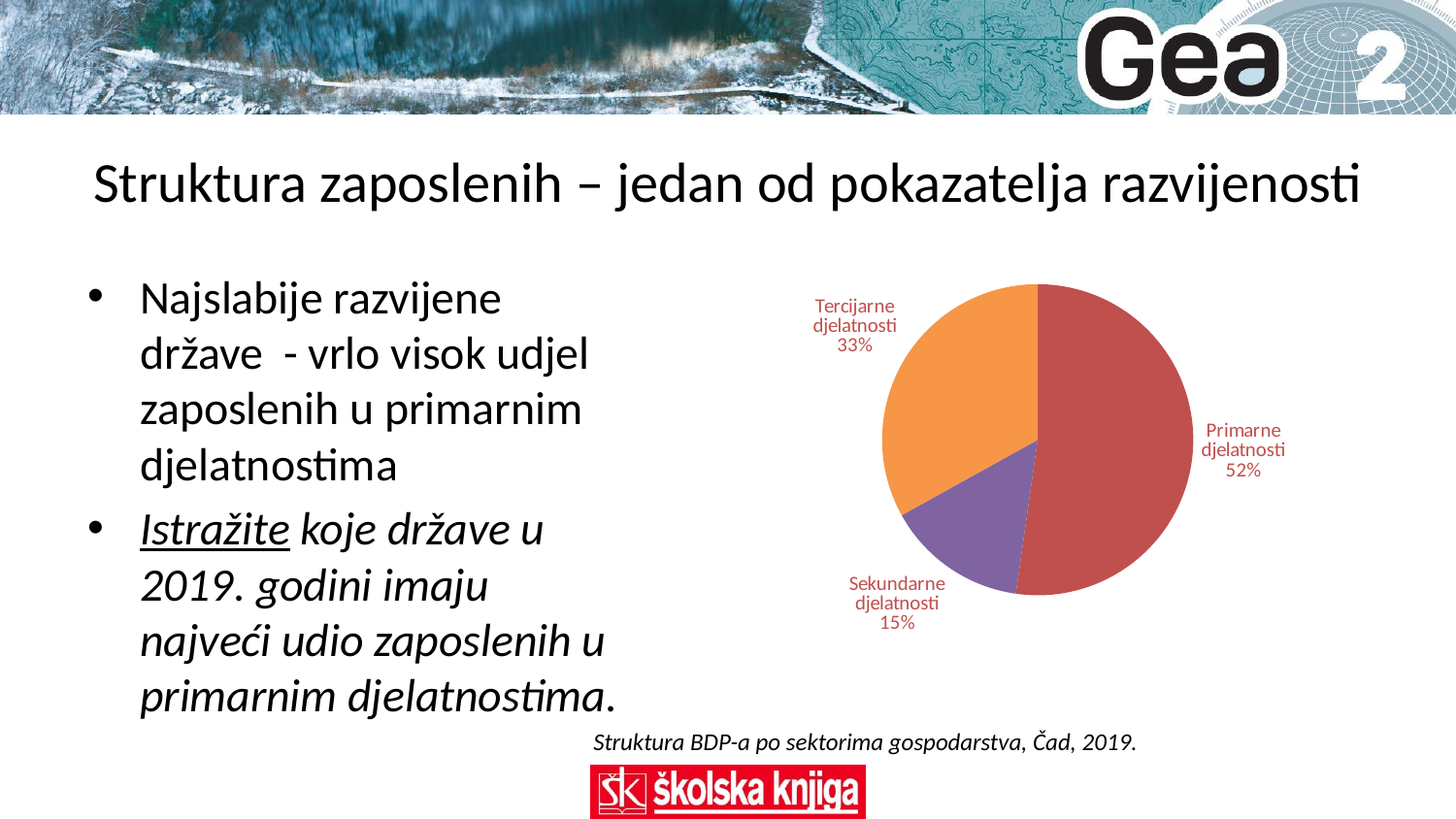
What is the difference in percentage points between Tercijarne djelatnosti and Sekundarne djelatnosti? 18 What is the caption below the pie chart? Struktura BDP-a po sektorima gospodarstva, Čad, 2019. What colour is the Sekundarne djelatnosti slice? purple How many slices does the pie chart have? 3 What is the difference in percentage points between Primarne djelatnosti and Tercijarne djelatnosti? 19 What share of the pie chart is Sekundarne djelatnosti? 15% What share of the pie chart is Tercijarne djelatnosti? 33% What share of the pie chart is Primarne djelatnosti? 52% Which is larger, the share of Tercijarne djelatnosti or Sekundarne djelatnosti? Tercijarne djelatnosti Which sector has the largest slice in the pie chart? Primarne djelatnosti Which sector has the smallest slice in the pie chart? Sekundarne djelatnosti What kind of chart is shown on the slide? pie chart